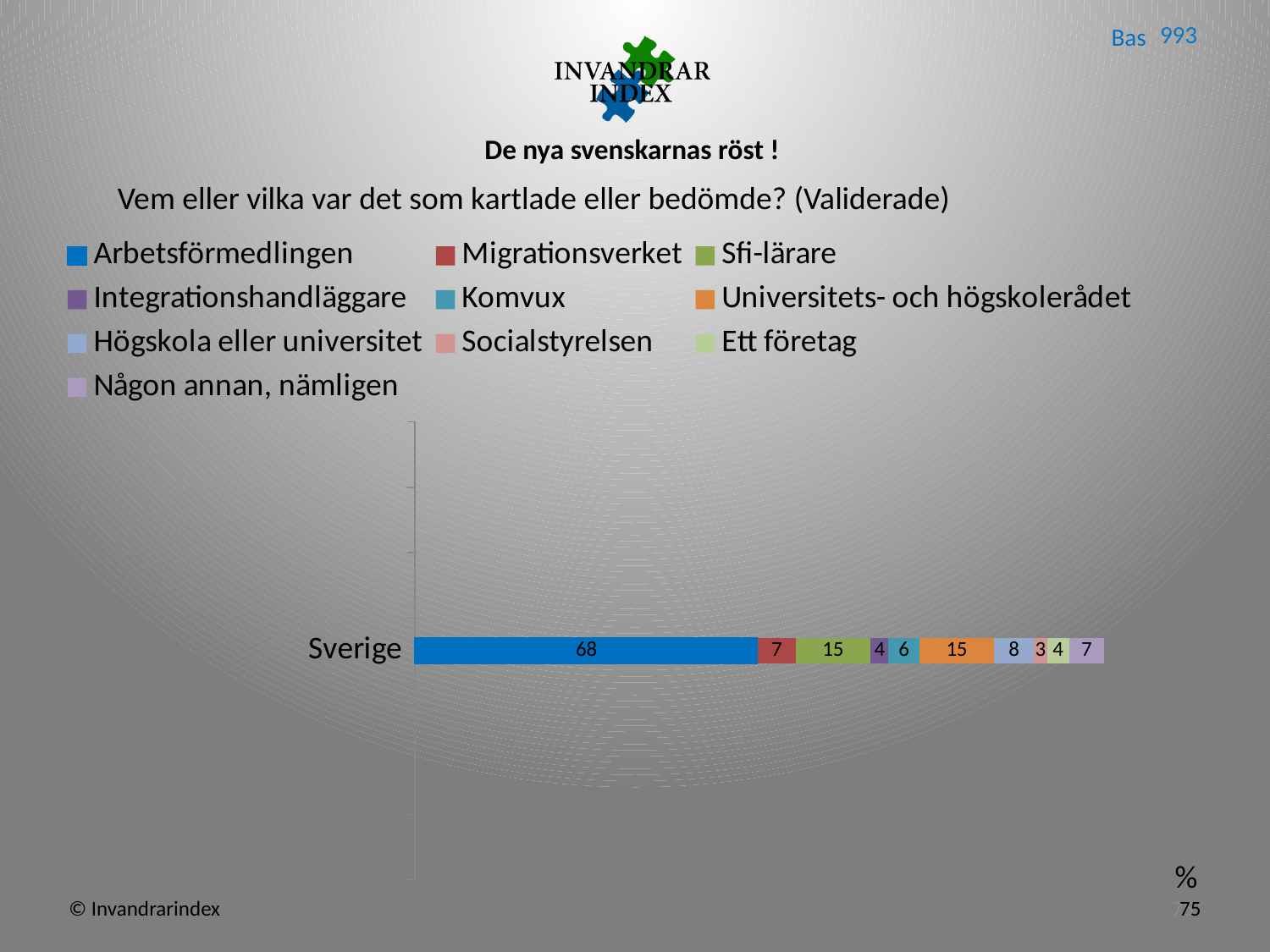
Which series has the highest value in the Sverige bar? Arbetsförmedlingen Which is larger, the value for Migrationsverket or the value for Högskola eller universitet? Högskola eller universitet What is the value for Arbetsförmedlingen in the Sverige bar? 68 What is the value for Sfi-lärare in the Sverige bar? 15 What is the value for Komvux in the Sverige bar? 6 What is the value for Socialstyrelsen in the Sverige bar? 3 What is the difference between the values for Arbetsförmedlingen and Universitets- och högskolerådet? 53 How many series does the legend list? 10 Which series has the lowest value in the Sverige bar? Socialstyrelsen What is the value for Högskola eller universitet in the Sverige bar? 8 What kind of chart is shown on the slide? stacked bar chart What is the total of all segments in the Sverige bar? 137